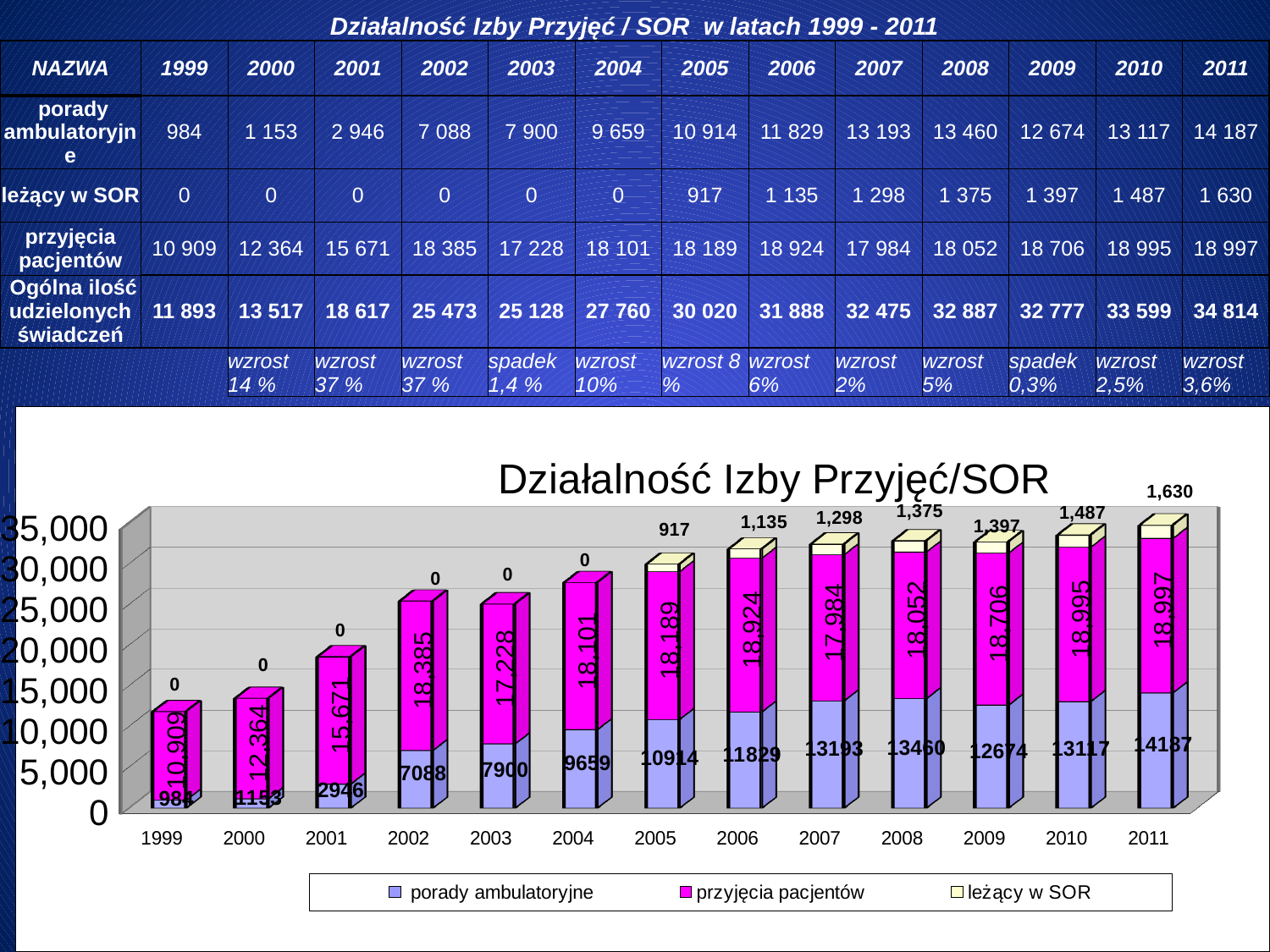
What is the total height of the stacked bar for 2011 in the chart? 34,814 What is the difference between 'przyjęcia pacjentów' in 2011 and in 1999 in the chart? 8,088 What is the value of 'przyjęcia pacjentów' for 2002 in the chart? 18,385 What is the title of the chart? Działalność Izby Przyjęć/SOR What is the value of 'porady ambulatoryjne' for 2004 in the chart? 9659 What is the value of 'leżący w SOR' for 2011 in the chart? 1,630 How many series does the chart legend list? 3 In which year is 'porady ambulatoryjne' lowest in the chart? 1999 In which year is 'leżący w SOR' highest in the chart? 2011 Which is larger in the chart: 'porady ambulatoryjne' in 2009 or in 2010? 2010 How many years are shown on the x axis of the chart? 13 What kind of chart is shown on the slide? stacked bar chart